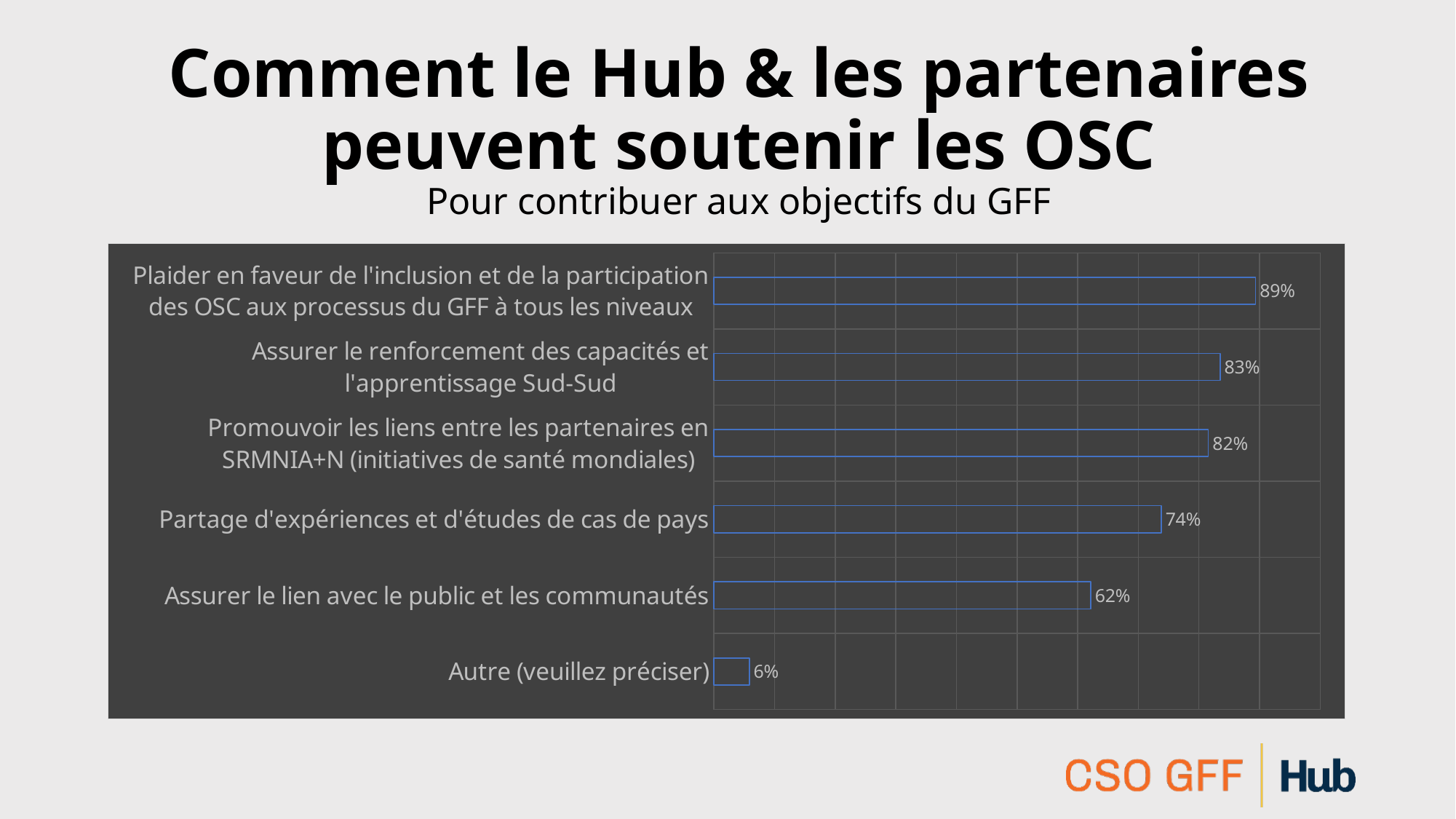
What is the value for "Assurer le renforcement des capacités et l'apprentissage Sud-Sud"? 83% What is the value for "Assurer le lien avec le public et les communautés"? 62% What is the value for "Partage d'expériences et d'études de cas de pays"? 74% What is the subtitle shown below the main title of the slide? Pour contribuer aux objectifs du GFF Which category has the highest value? Plaider en faveur de l'inclusion et de la participation des OSC aux processus du GFF à tous les niveaux Which is larger: the value for "Promouvoir les liens entre les partenaires en SRMNIA+N (initiatives de santé mondiales)" or the value for "Partage d'expériences et d'études de cas de pays"? Promouvoir les liens entre les partenaires en SRMNIA+N (initiatives de santé mondiales) What is the difference between the values for "Partage d'expériences et d'études de cas de pays" and "Assurer le lien avec le public et les communautés"? 12% What kind of chart is shown on the slide? Bar chart Which category has the lowest value? Autre (veuillez préciser) How many categories are shown in the chart? 6 What is the value for "Plaider en faveur de l'inclusion et de la participation des OSC aux processus du GFF à tous les niveaux"? 89% What is the value for "Autre (veuillez préciser)"? 6%